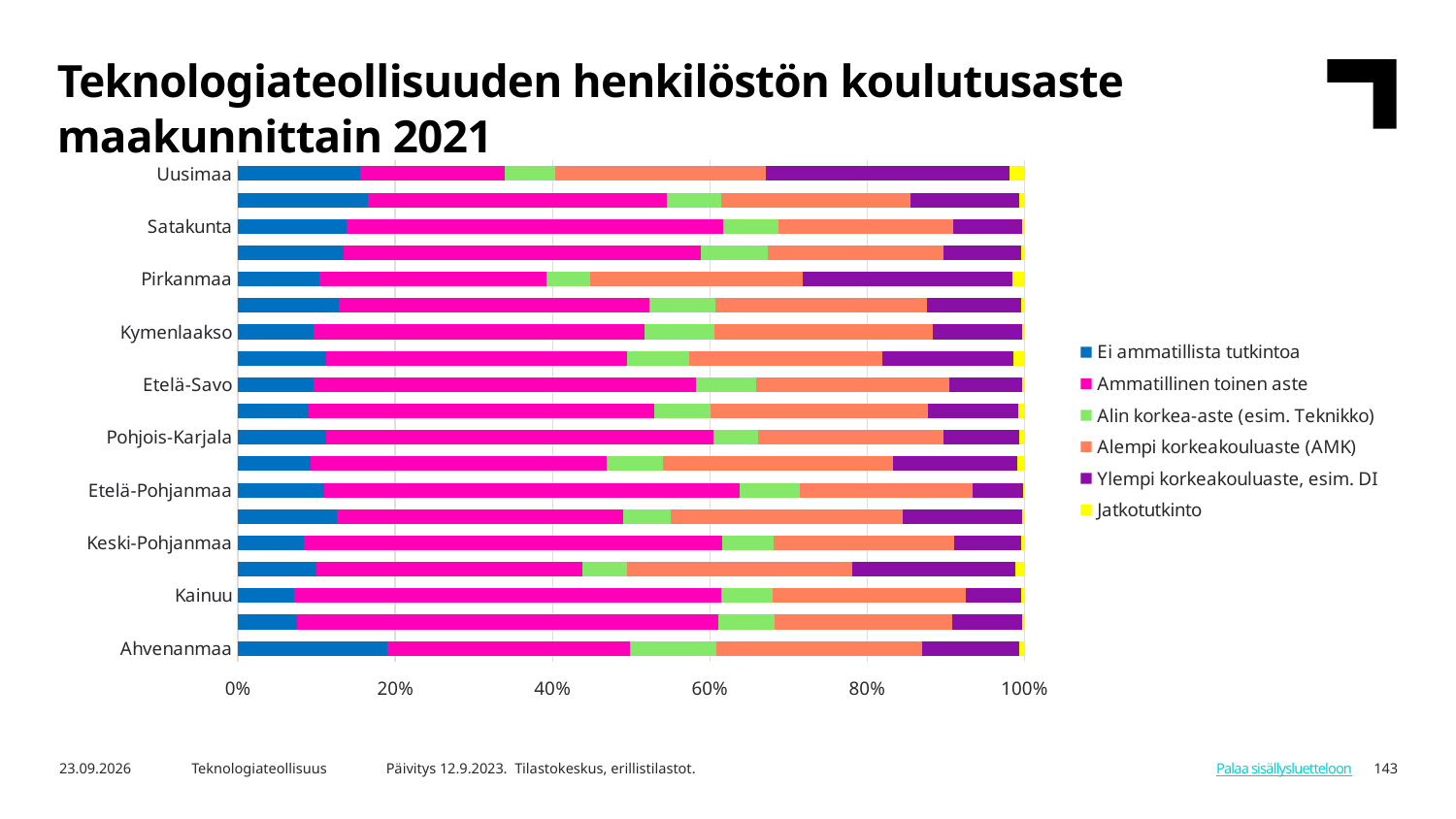
Is the share of Ei ammatillista tutkintoa for Pirkanmaa greater or less than 20%? less Which colour represents Jatkotutkinto in the legend? Yellow Which region has the larger share of Ylempi korkeakouluaste, esim. DI, Uusimaa or Kainuu? Uusimaa What is the maximum value shown on the horizontal axis? 100% How many series does the legend list? 6 What does each stacked bar total? 100% What kind of chart is shown on the slide? Stacked bar chart Which labelled region has the largest share of Ylempi korkeakouluaste, esim. DI? Uusimaa Which region has the larger share of Ammatillinen toinen aste, Satakunta or Uusimaa? Satakunta Is the share of Ei ammatillista tutkintoa for Uusimaa greater or less than 20%? less What is the title of the chart? Teknologiateollisuuden henkilöstön koulutusaste maakunnittain 2021 Which region has the larger share of Ei ammatillista tutkintoa, Ahvenanmaa or Kainuu? Ahvenanmaa